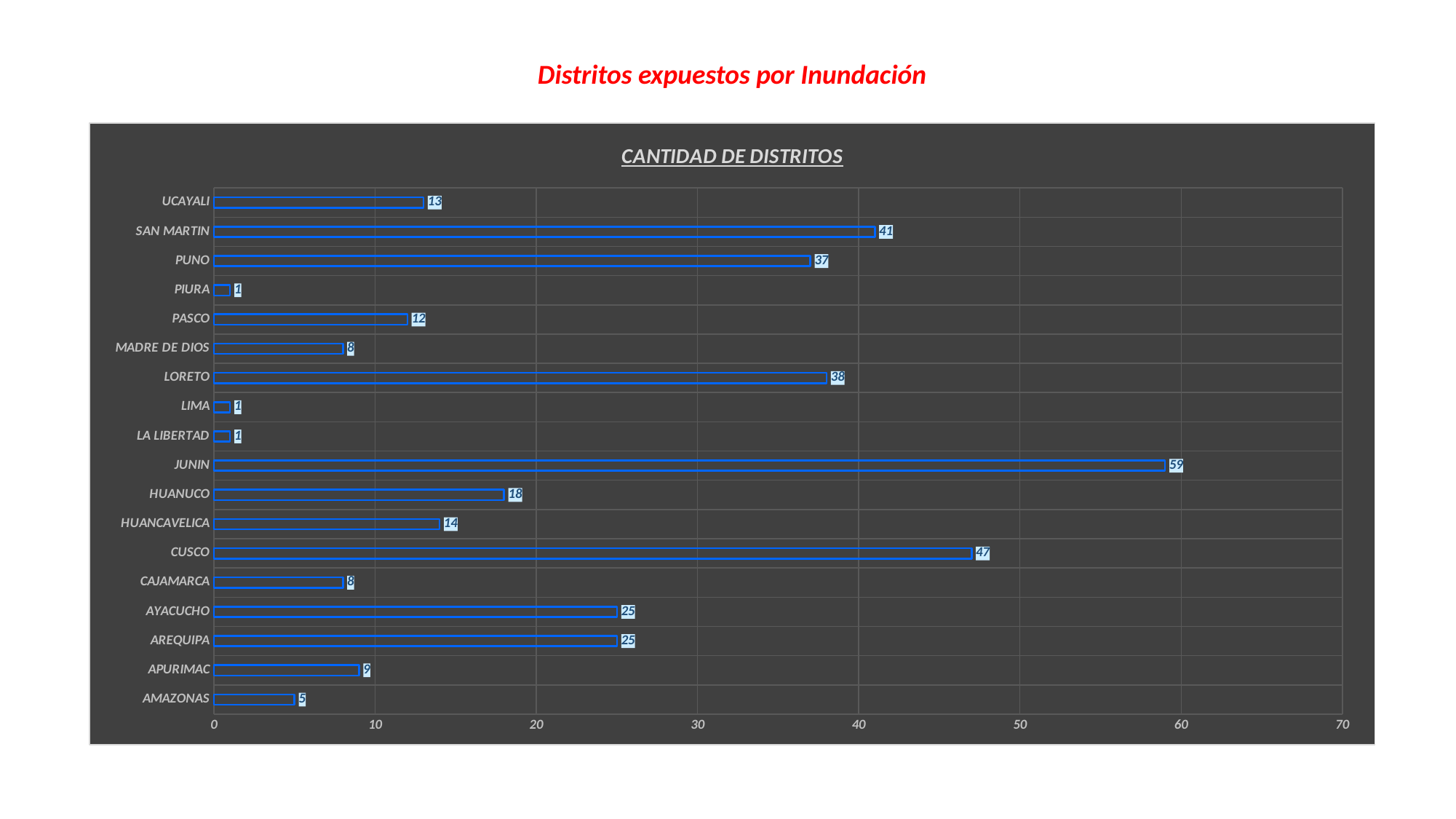
What is the value for LORETO? 38 What is the difference between the values for CUSCO and SAN MARTIN? 6 Which region has the highest value? JUNIN What is the value for AMAZONAS? 5 How many categories (regions) are plotted in the chart? 18 What is the difference between the values for JUNIN and CUSCO? 12 What type of chart is shown on the slide? bar chart What is the value for MADRE DE DIOS? 8 What is the title of the chart? CANTIDAD DE DISTRITOS Is the value for HUANUCO greater or less than 20? less Which is larger, the value for PUNO or the value for LORETO? LORETO What is the value for JUNIN? 59